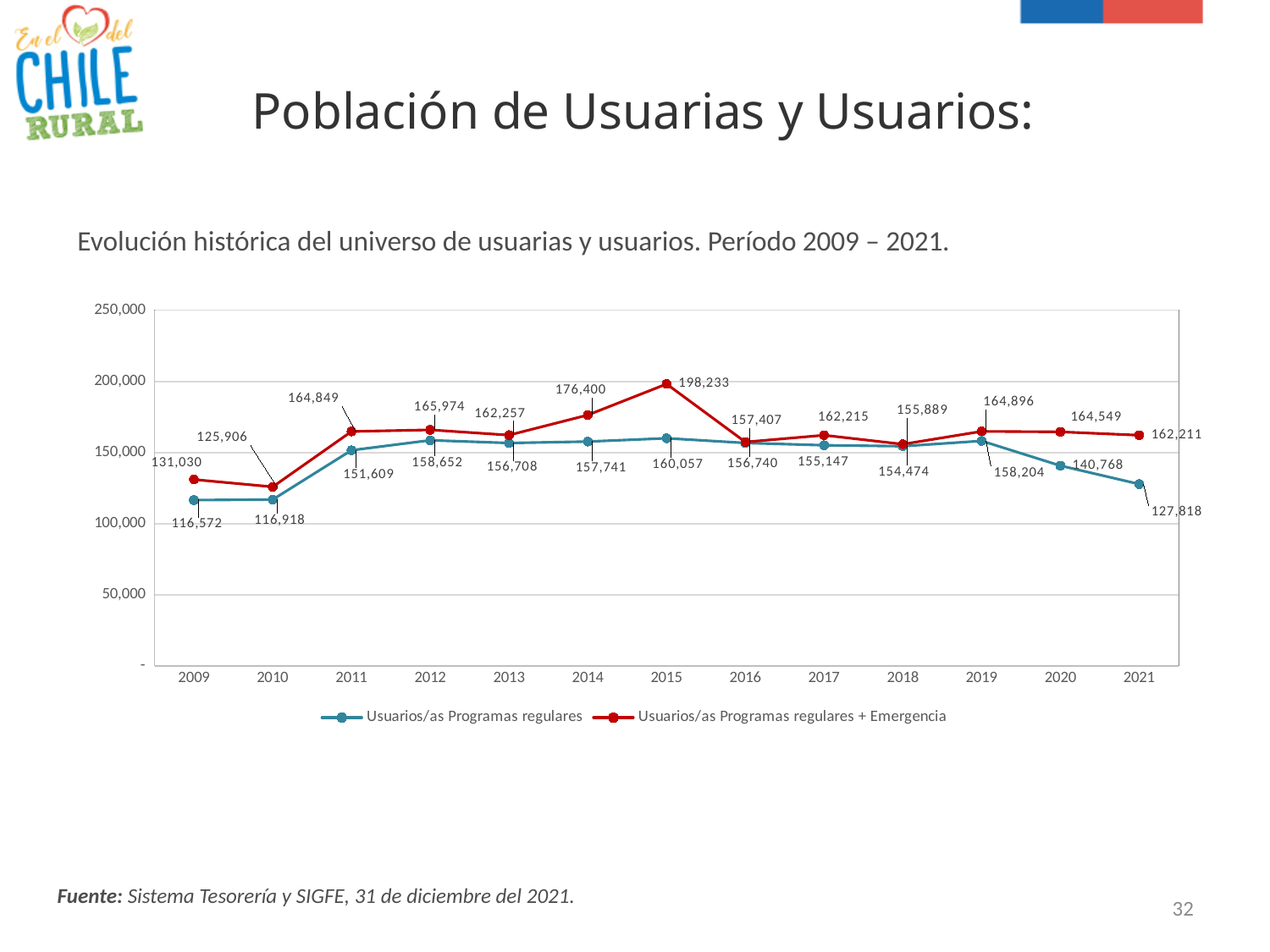
In which year is the Usuarios/as Programas regulares + Emergencia series at its lowest? 2010 What is the value for Usuarios/as Programas regulares + Emergencia in 2015? 198,233 Is the value for Usuarios/as Programas regulares in 2011 greater or less than 150,000? greater What is the legend label of the red line? Usuarios/as Programas regulares + Emergencia In which year does the Usuarios/as Programas regulares + Emergencia series reach its highest value? 2015 What kind of chart is shown on the slide? line chart What is the value for Usuarios/as Programas regulares in 2021? 127,818 What is the difference between the two series in 2015? 38,176 In 2020, which series has the larger value: Usuarios/as Programas regulares or Usuarios/as Programas regulares + Emergencia? Usuarios/as Programas regulares + Emergencia How many series does the legend list? 2 Does the Usuarios/as Programas regulares series rise or fall from 2019 to 2021? fall How many years are plotted on the x axis? 13